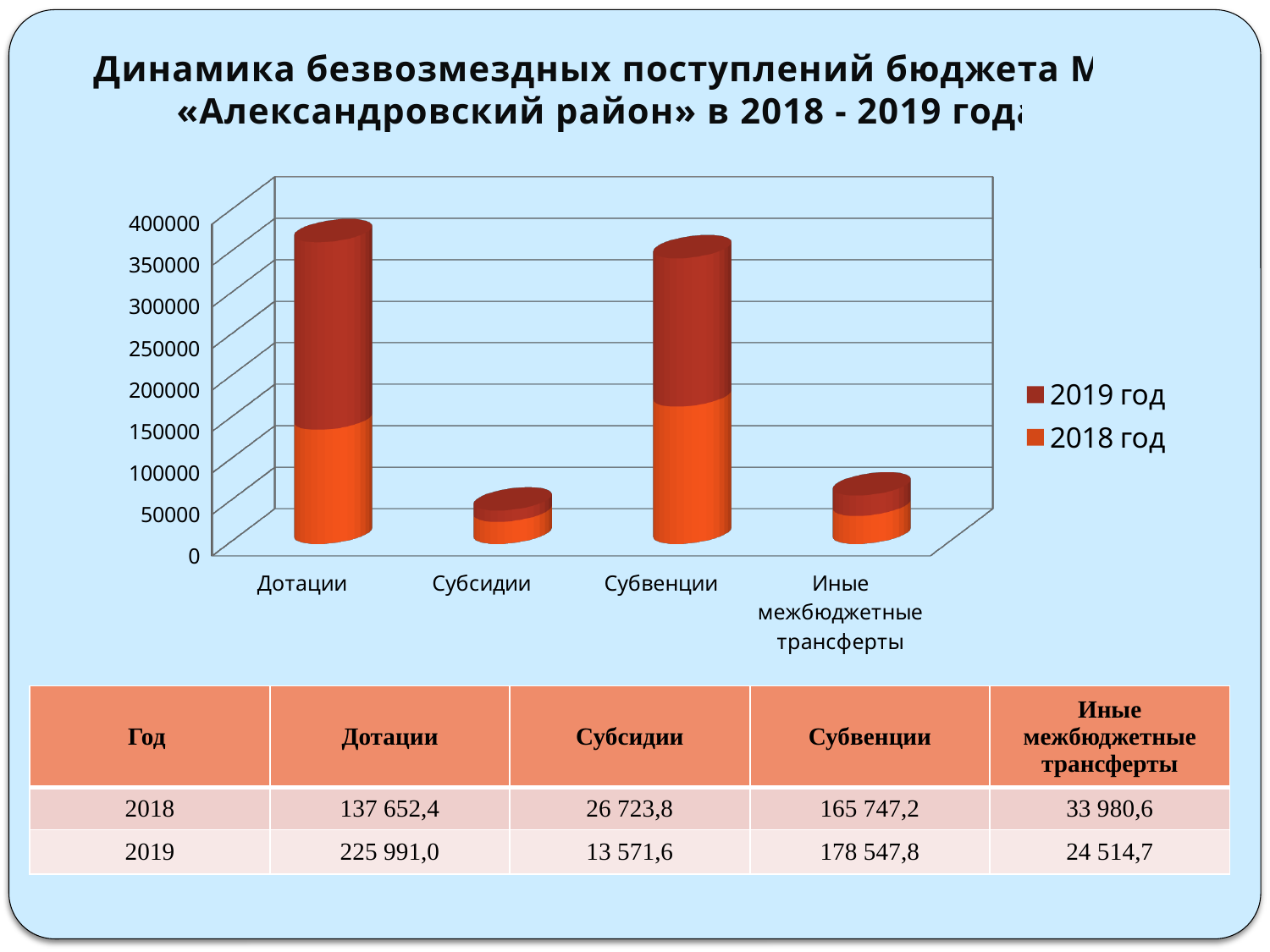
Which category has the shortest stacked bar in the chart? Субсидии Which is larger for Субсидии: the 2018 value or the 2019 value? 2018 год How many series does the chart legend list? 2 Which category has the tallest stacked bar in the chart? Дотации What kind of chart is shown on the slide? bar chart How many categories are shown on the x axis of the chart? 4 What is the value for Субсидии in 2019? 13 571,6 Which series are listed in the chart legend? 2019 год, 2018 год What is the difference between the 2019 and 2018 values for Дотации? 88 338,6 Is the total stacked value for Иные межбюджетные трансферты greater or less than 50000? greater What is the value for Дотации in 2018? 137 652,4 What is the value for Иные межбюджетные трансферты in 2018? 33 980,6